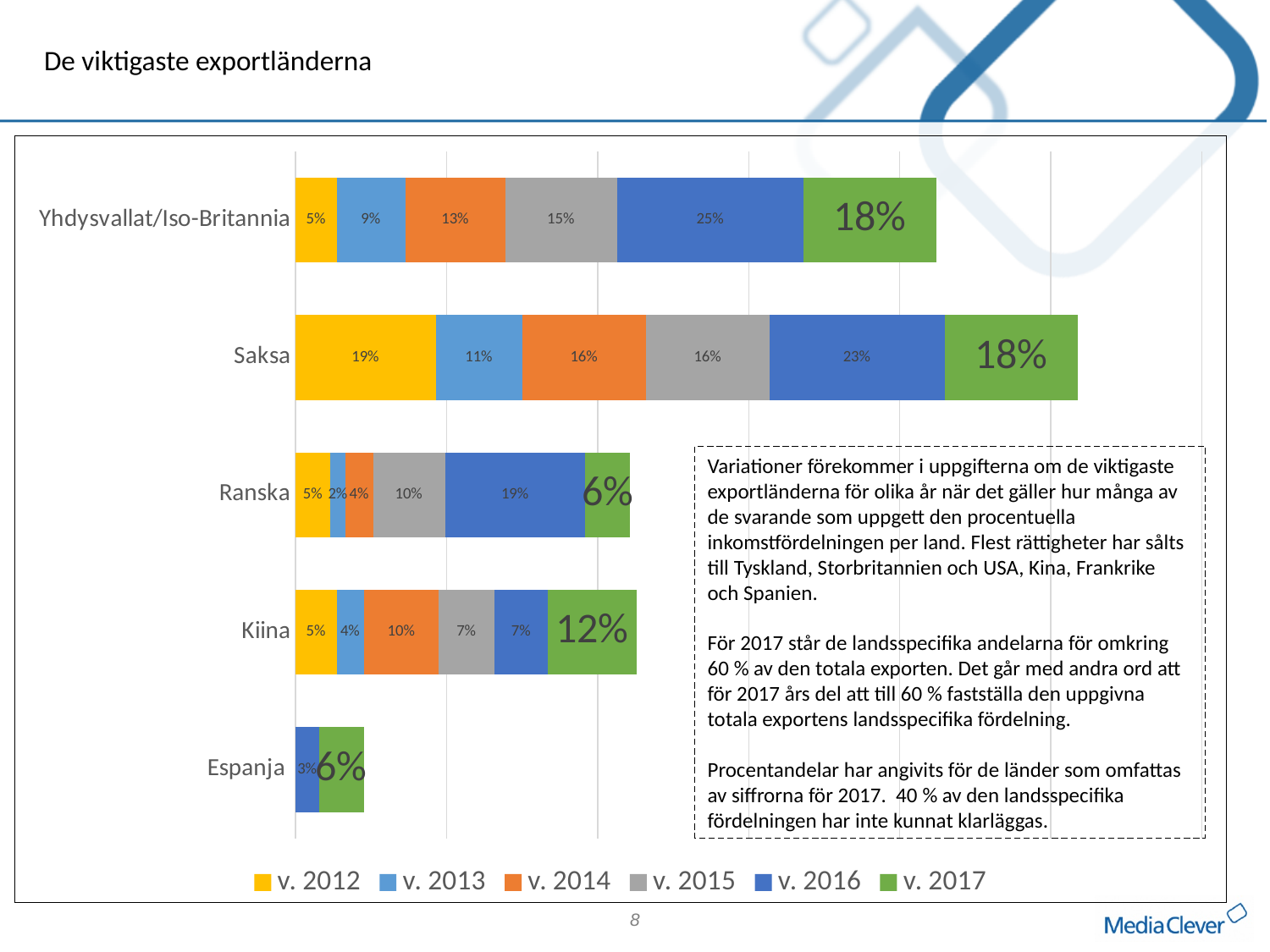
Which country has the lowest v. 2016 value? Espanja What is the v. 2012 value for Saksa? 19% How many countries are shown on the chart? 5 What is the v. 2016 value for Yhdysvallat/Iso-Britannia? 25% How many series does the legend list? 6 What is the difference between the v. 2016 values for Saksa and Ranska? 4% What is the total of the stacked bar for Kiina? 45% Which country has the highest v. 2017 value? Yhdysvallat/Iso-Britannia and Saksa (both 18%) What is the v. 2017 value for Kiina? 12% Which is larger, the v. 2014 value for Kiina or the v. 2014 value for Ranska? Kiina What is the v. 2016 value for Espanja? 3% What kind of chart is shown on the slide? Stacked bar chart